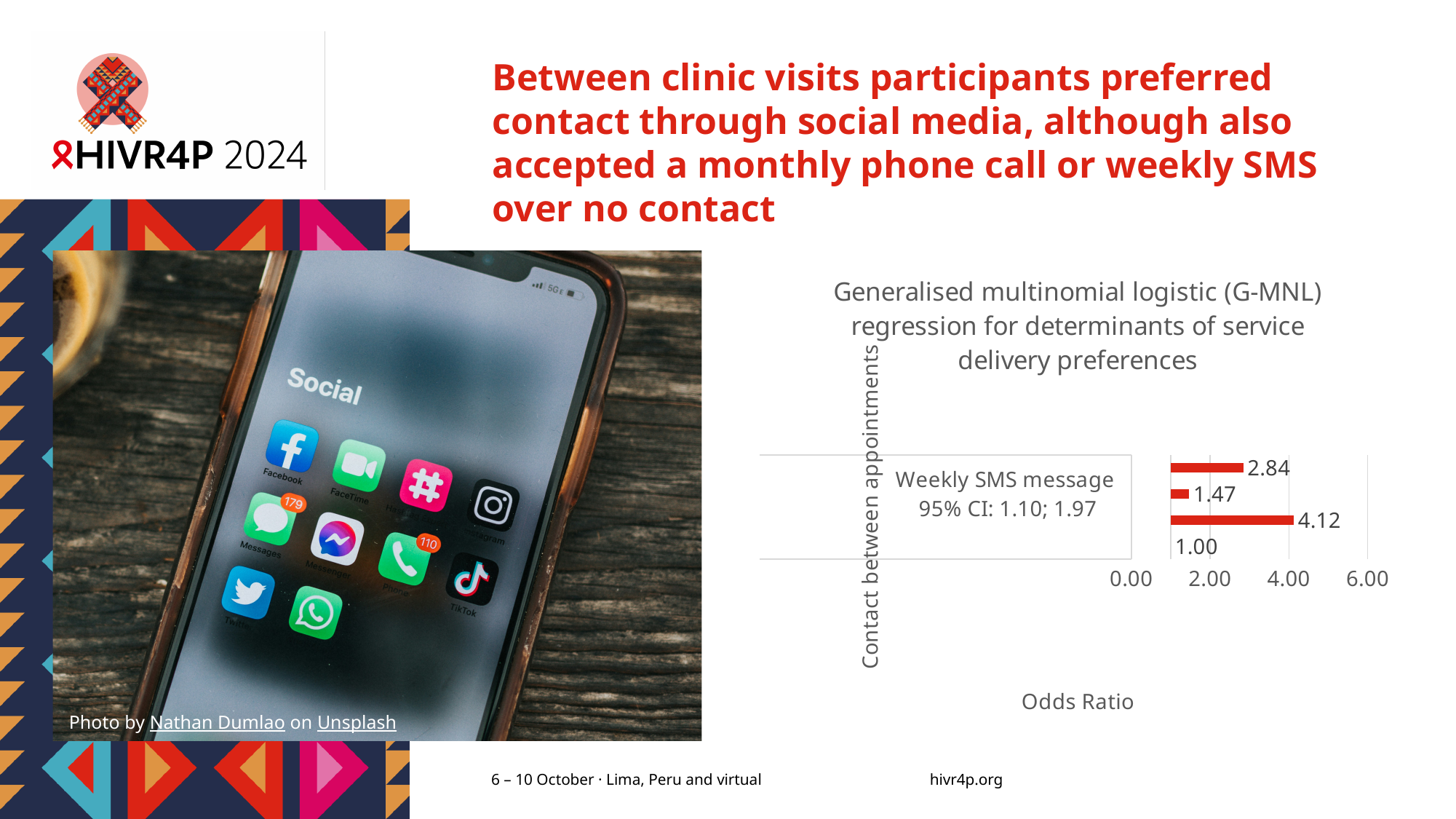
What is the highest odds ratio value labelled in the chart? 4.12 What is the highest tick value shown on the horizontal axis of the chart? 6.00 What is the label of the horizontal axis of the chart? Odds Ratio How many data labels (bars) are shown in the chart? 4 Is the largest odds ratio in the chart greater or less than 4.00? greater What is the difference between the labelled values 2.84 and 1.47 in the chart? 1.37 What is the difference between the highest labelled value (4.12) and the second highest (2.84) in the chart? 1.28 What kind of chart is shown on the slide? Bar chart Which is larger in the chart, the bar labelled 2.84 or the bar labelled 1.47? 2.84 What 95% confidence interval is given for the weekly SMS message in the chart's text box? 1.10; 1.97 What is the title of the chart on the slide? Generalised multinomial logistic (G-MNL) regression for determinants of service delivery preferences What is the lowest odds ratio value labelled in the chart? 1.00